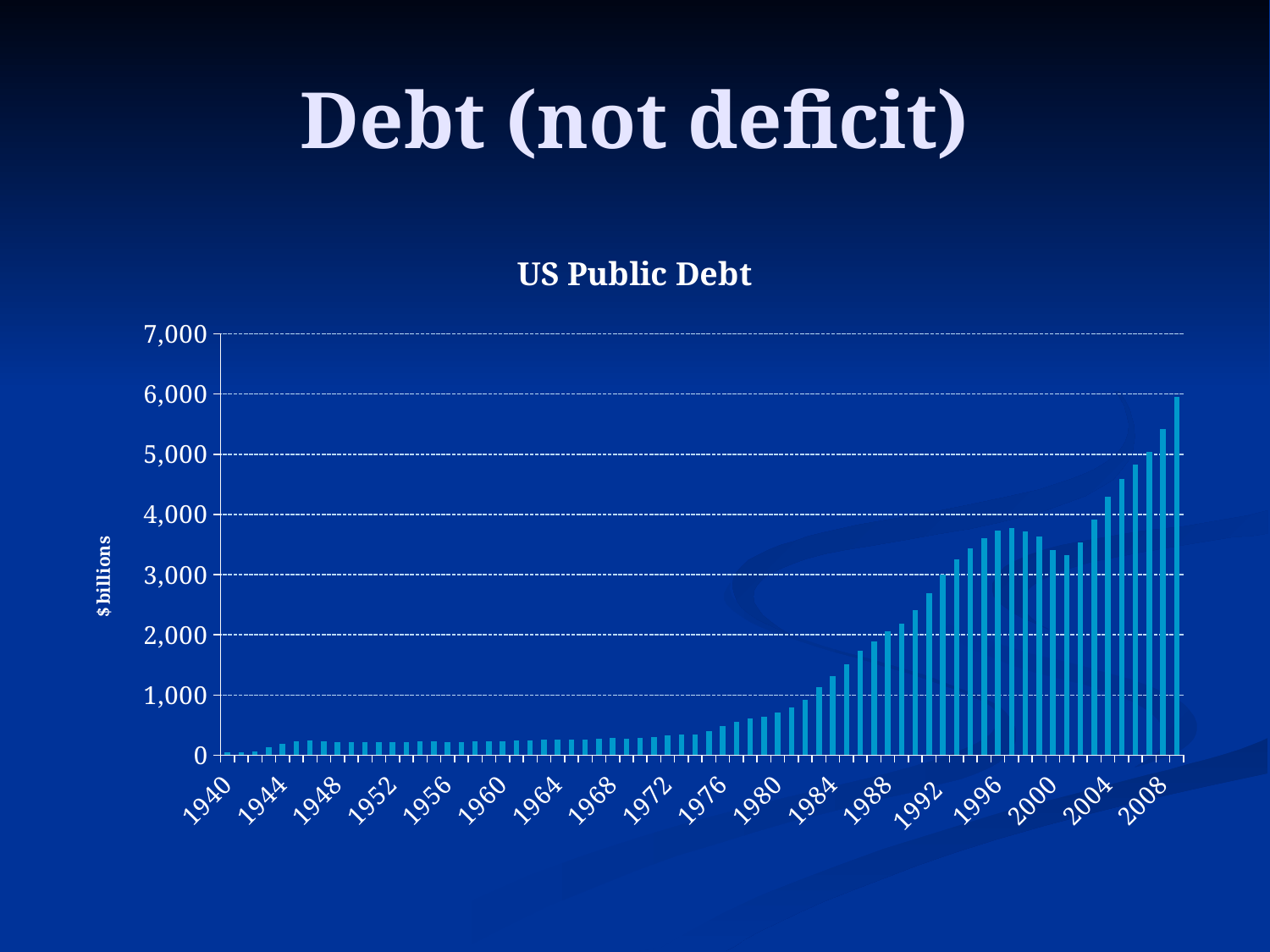
Is the value for 1960 greater or less than 1,000? less What kind of chart is shown on the slide? bar chart Is the value for 1996 greater or less than 3,000? greater What is the label on the vertical axis of the chart? $ billions Is the value for 1976 greater or less than 1,000? less Which year has the larger value, 1940 or 1944? 1944 What is the title of the chart? US Public Debt Overall, do the values rise or fall from 1940 to the right end of the x axis? rise Which year has the larger value, 1980 or 2000? 2000